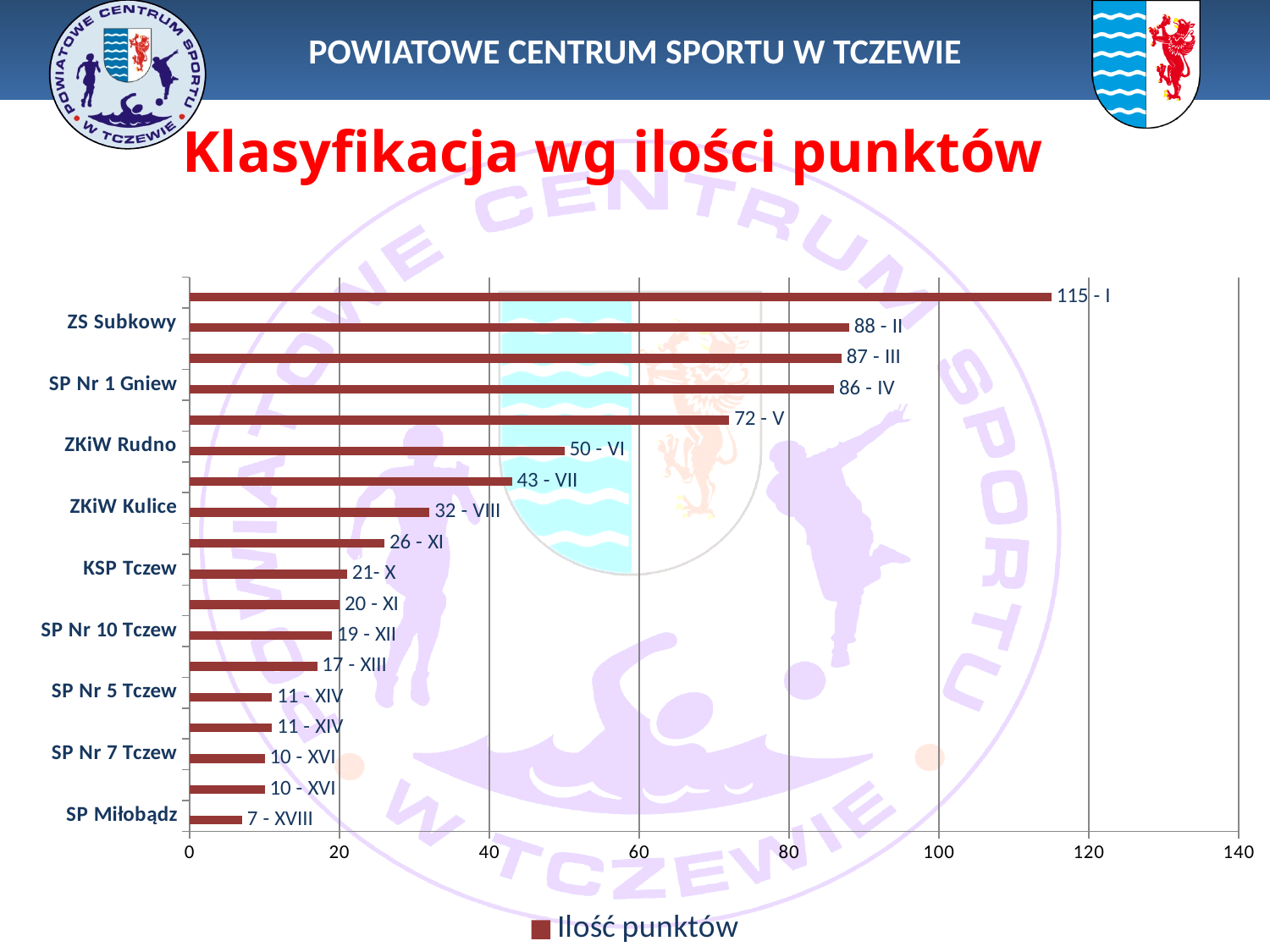
How many points does SP Nr 1 Gniew have according to its data label? 86 How many points does ZS Subkowy have according to its data label? 88 How many points does ZKiW Rudno have according to its data label? 50 What is the title of the chart on the slide? Klasyfikacja wg ilości punktów Which labeled school has the lowest number of points? SP Miłobądz How many series does the legend list? 1 What is the difference in points between ZS Subkowy and SP Nr 1 Gniew? 2 How many bars are plotted in the chart? 18 What series name does the chart legend show? Ilość punktów Which has more points, ZKiW Kulice or KSP Tczew? ZKiW Kulice What is the highest value shown by a data label in the chart? 115 What type of chart is shown on the slide? bar chart